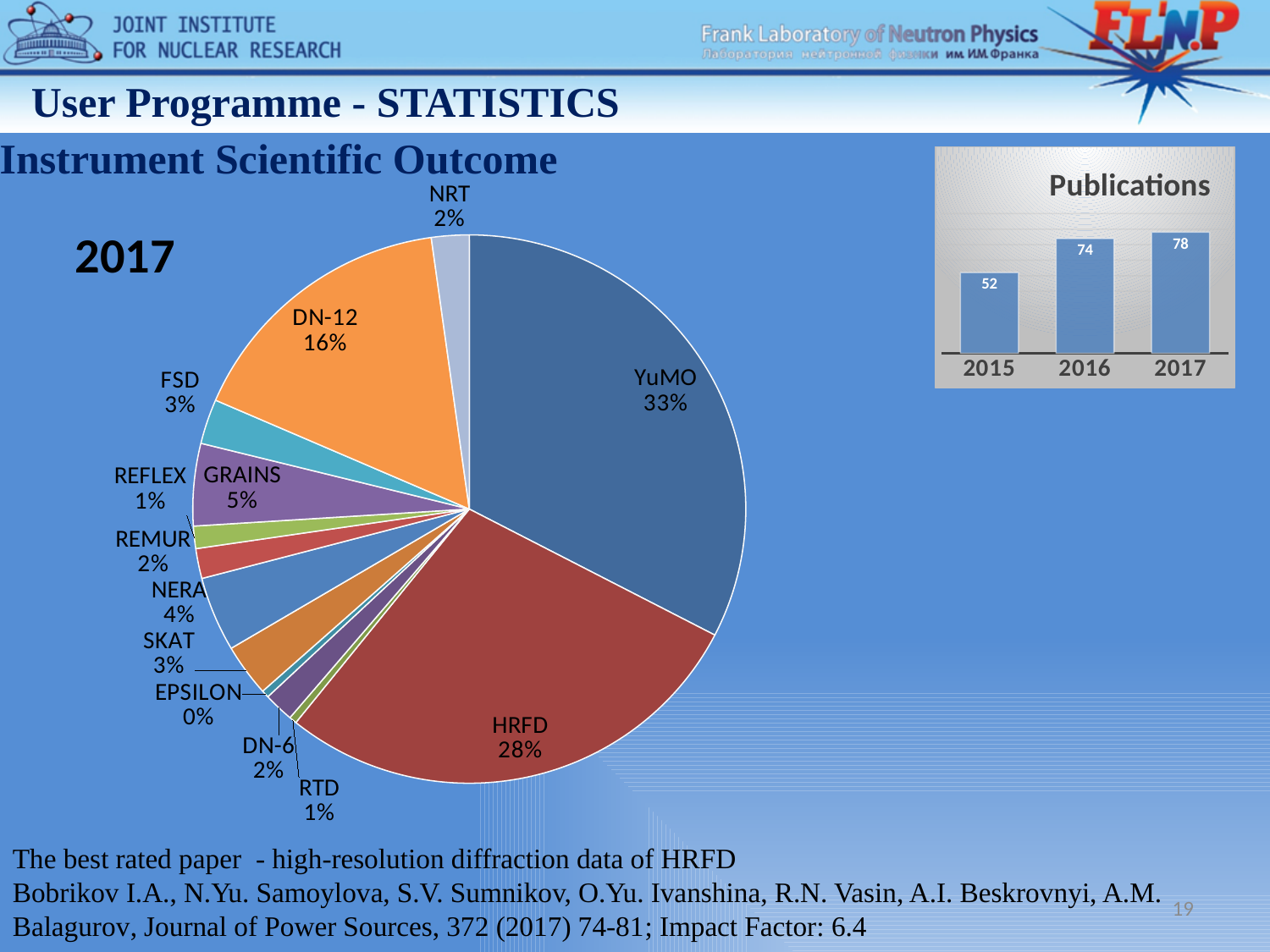
In the Publications bar chart, how many publications were there in 2016? 74 What kind of chart is the Publications chart? bar chart In the pie chart on the left, which instrument has the largest slice? YuMO In the Publications bar chart, what is the difference between the 2017 and 2015 values? 26 How many slices does the pie chart on the left have? 13 In the pie chart on the left, what is the difference between the YuMO and HRFD shares? 5% In the pie chart on the left, which is larger, HRFD or DN-12? HRFD In the Publications bar chart, which year has the highest number of publications? 2017 In the pie chart on the left, what share does DN-12 have? 16% In the pie chart on the left, what share does YuMO have? 33% In the Publications bar chart, do the values rise or fall from 2015 to 2017? rise In the Publications bar chart, which year has the lowest number of publications? 2015